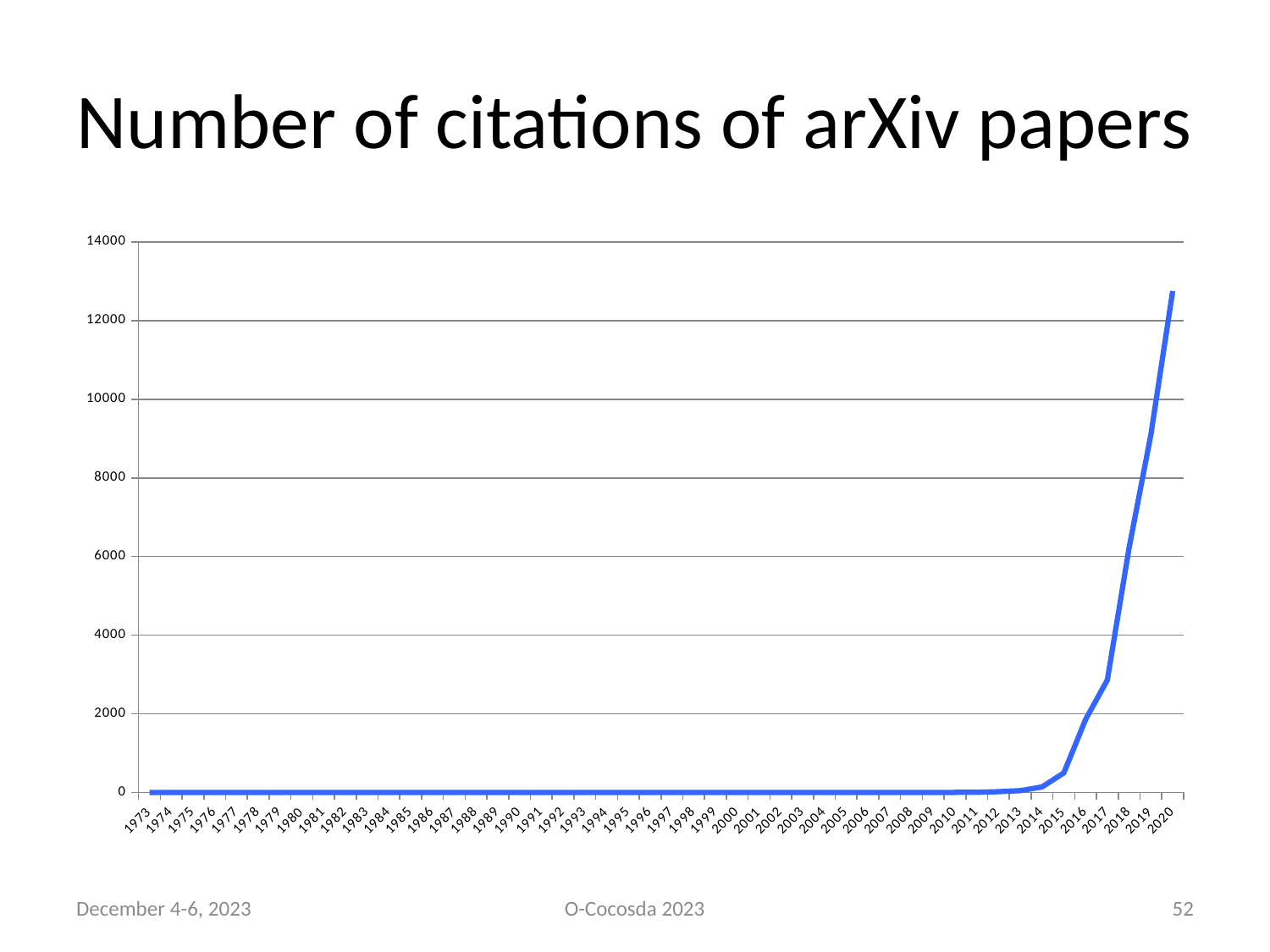
Is the value for 2019 greater or less than 6000? greater What kind of chart is shown on the slide? line chart What is the highest tick value shown on the y axis? 14000 Is the value for 2017 greater or less than 2000? greater Which year has the larger value, 2020 or 2017? 2020 Do the values generally rise or fall along the x axis from 1973 to 2020? rise What is the title of the chart? Number of citations of arXiv papers Which year has the highest number of citations? 2020 Is the value for 2015 greater or less than 2000? less How many years are plotted on the x axis? 48